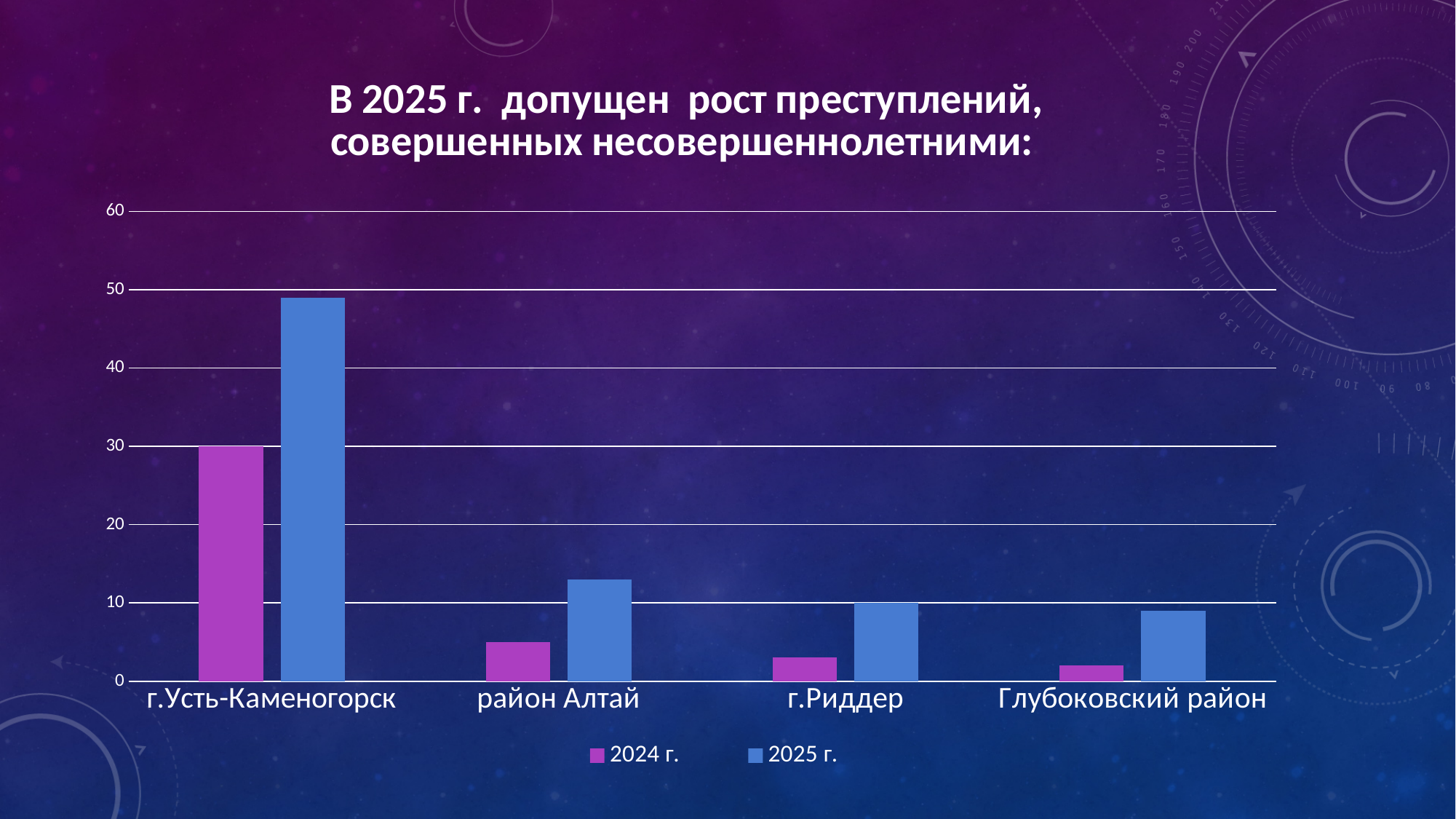
What is the value for г.Риддер in the 2025 г. series? 10 What kind of chart is shown on the slide? bar chart What is the value for г.Усть-Каменогорск in the 2024 г. series? 30 Is the value for Глубоковский район in the 2025 г. series greater or less than 10? less For г.Усть-Каменогорск, which series has the larger value, 2024 г. or 2025 г.? 2025 г. How many categories are shown on the x axis of the chart? 4 What are the two series listed in the legend? 2024 г. and 2025 г. Is the value for район Алтай in the 2025 г. series greater or less than 10? greater How many series does the chart's legend list? 2 Which category has the highest value in the 2024 г. series? г.Усть-Каменогорск Which category has the highest value in the 2025 г. series? г.Усть-Каменогорск Is the value for г.Усть-Каменогорск in the 2025 г. series greater or less than 40? greater